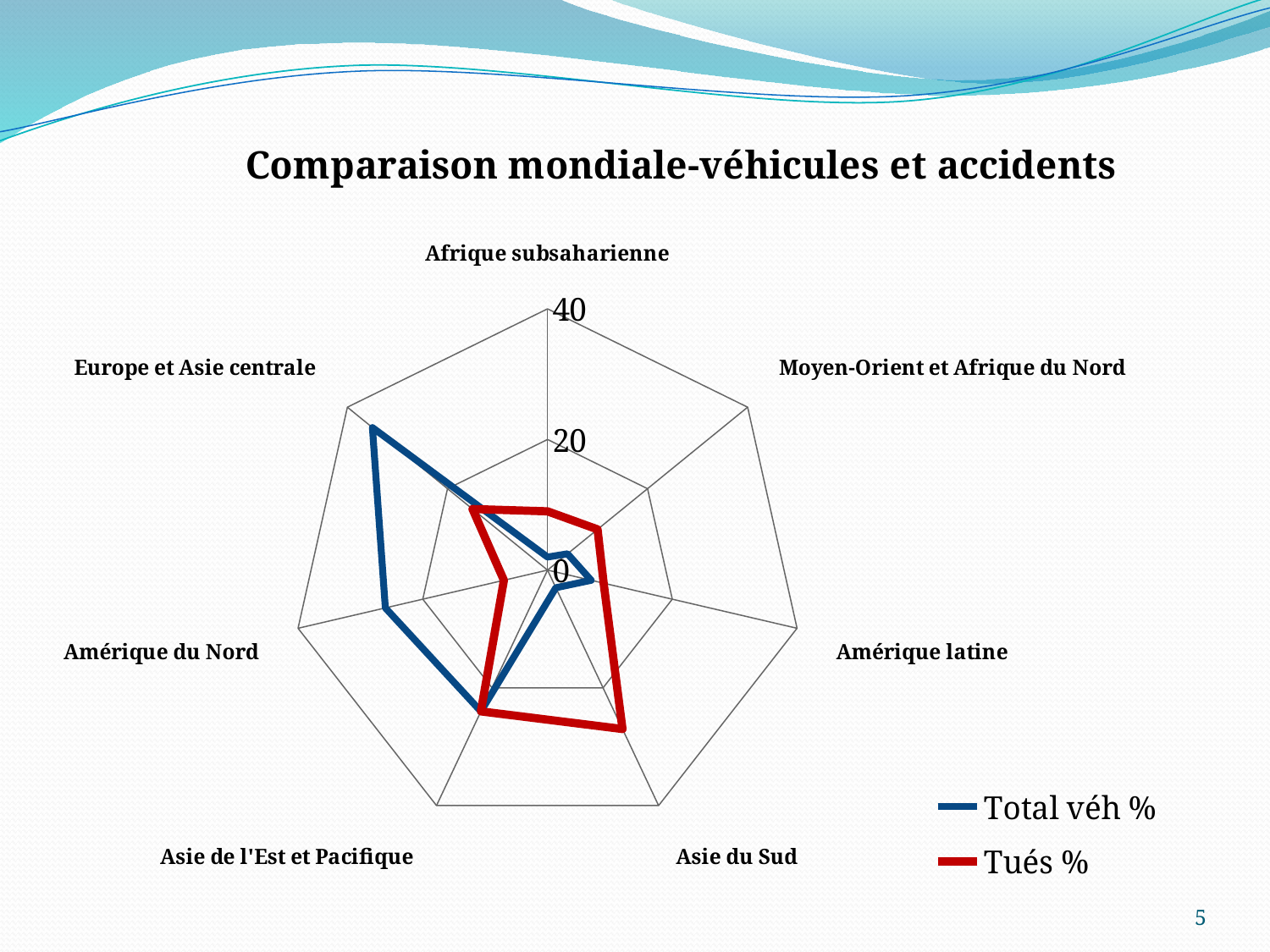
What is the title of the chart? Comparaison mondiale-véhicules et accidents Which region has the highest value for Total véh %? Europe et Asie centrale How many regions (categories) are plotted on the radar chart? 7 Is the Total véh % value for Europe et Asie centrale greater or less than 20? greater How many series does the legend list? 2 Which region has the lowest value for Total véh %? Afrique subsaharienne Is the Total véh % value for Afrique subsaharienne greater or less than 20? less Is the Tués % value for Asie du Sud greater or less than 20? greater Which region has the highest value for Tués %? Asie du Sud Which series is drawn in red according to the legend? Tués % For Asie du Sud, which series has the larger value: Total véh % or Tués %? Tués % What kind of chart is shown on the slide? Radar chart